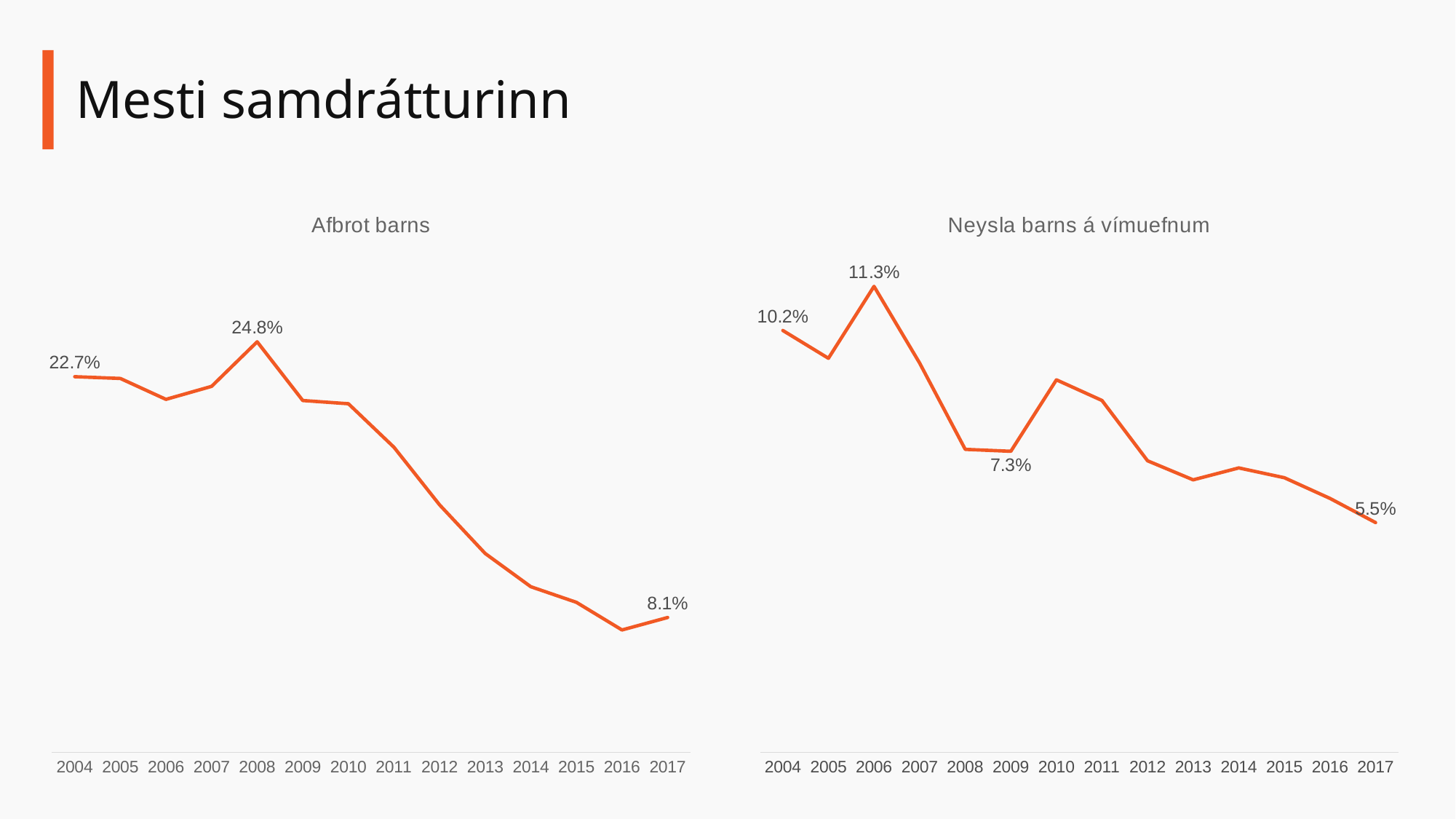
In the 'Afbrot barns' chart, what is the value for 2004? 22.7% In the 'Afbrot barns' chart, what is the difference between the 2008 value and the 2017 value? 16.7 percentage points In the 'Afbrot barns' chart, what is the value for 2008? 24.8% In the 'Neysla barns á vímuefnum' chart, which is larger, the value for 2006 or the value for 2009? 2006 What kind of chart is the 'Neysla barns á vímuefnum' chart? Line chart How many years are shown on the x axis of the 'Afbrot barns' chart? 14 In the 'Neysla barns á vímuefnum' chart, what is the value for 2006? 11.3% In the 'Neysla barns á vímuefnum' chart, what is the difference between the 2004 value and the 2017 value? 4.7 percentage points In the 'Neysla barns á vímuefnum' chart, which year has the lowest value? 2017 In the 'Afbrot barns' chart, which year has the highest value? 2008 In the 'Afbrot barns' chart, what is the value for 2017? 8.1% In the 'Neysla barns á vímuefnum' chart, what is the value for 2009? 7.3%